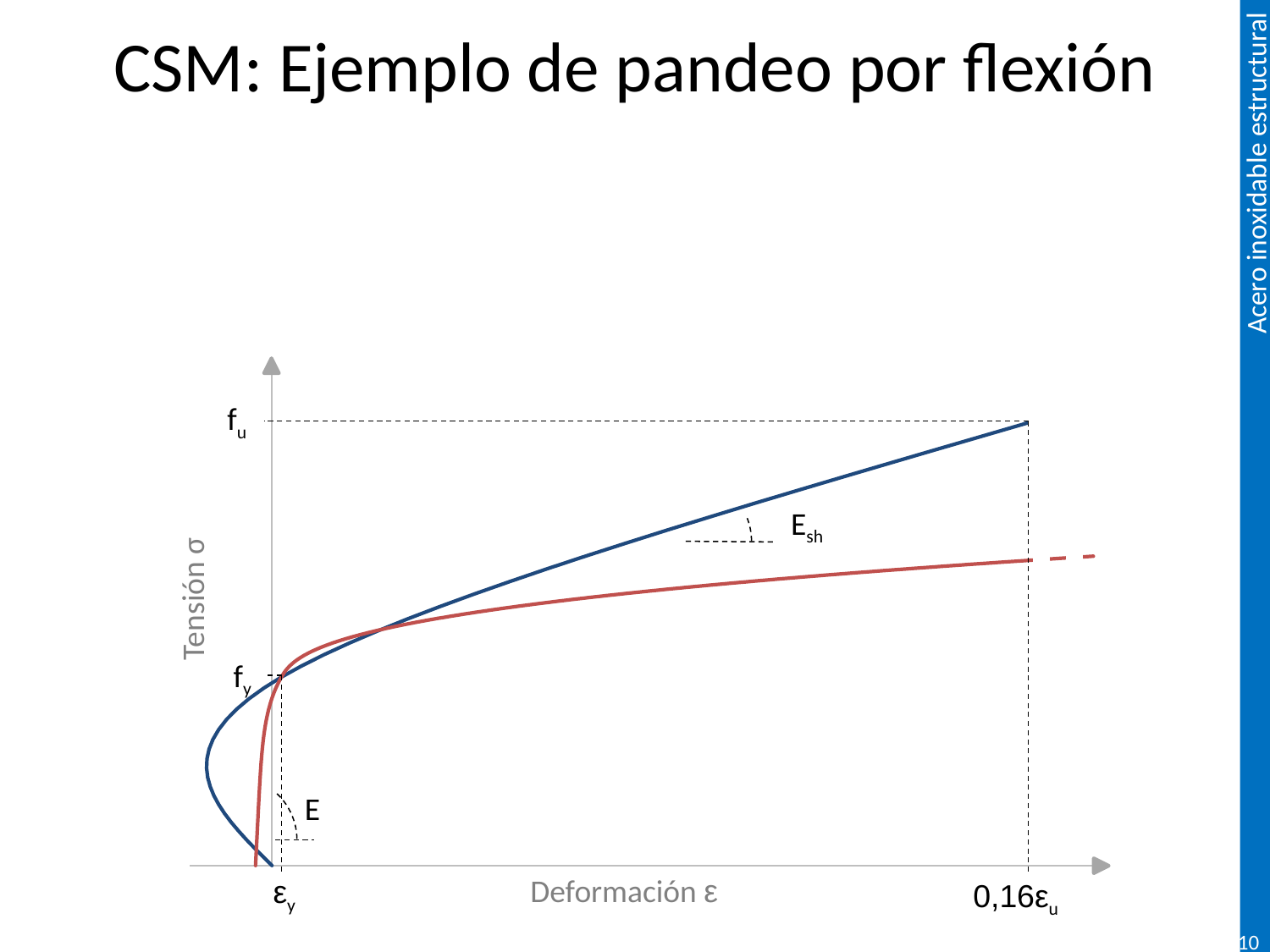
What is the lowest stress level labelled on the vertical axis? fy What kind of chart is shown on the slide? Line chart Does the stress on the blue line rise or fall as strain increases from εy to 0,16εu? Rise At the strain 0,16εu, which curve shows the higher stress, the blue one or the red one? The blue one How many curves are plotted on the chart? 2 What is the highest stress level labelled on the vertical axis? fu What stress value does the blue line reach at the strain 0,16εu? fu What slope label is shown for the blue line beyond the yield point? Esh What is the label of the horizontal axis? Deformación ε What is the label of the vertical axis? Tensión σ What slope label is shown for the initial part of the curve near the origin? E What stress value corresponds to the strain εy on the chart? fy